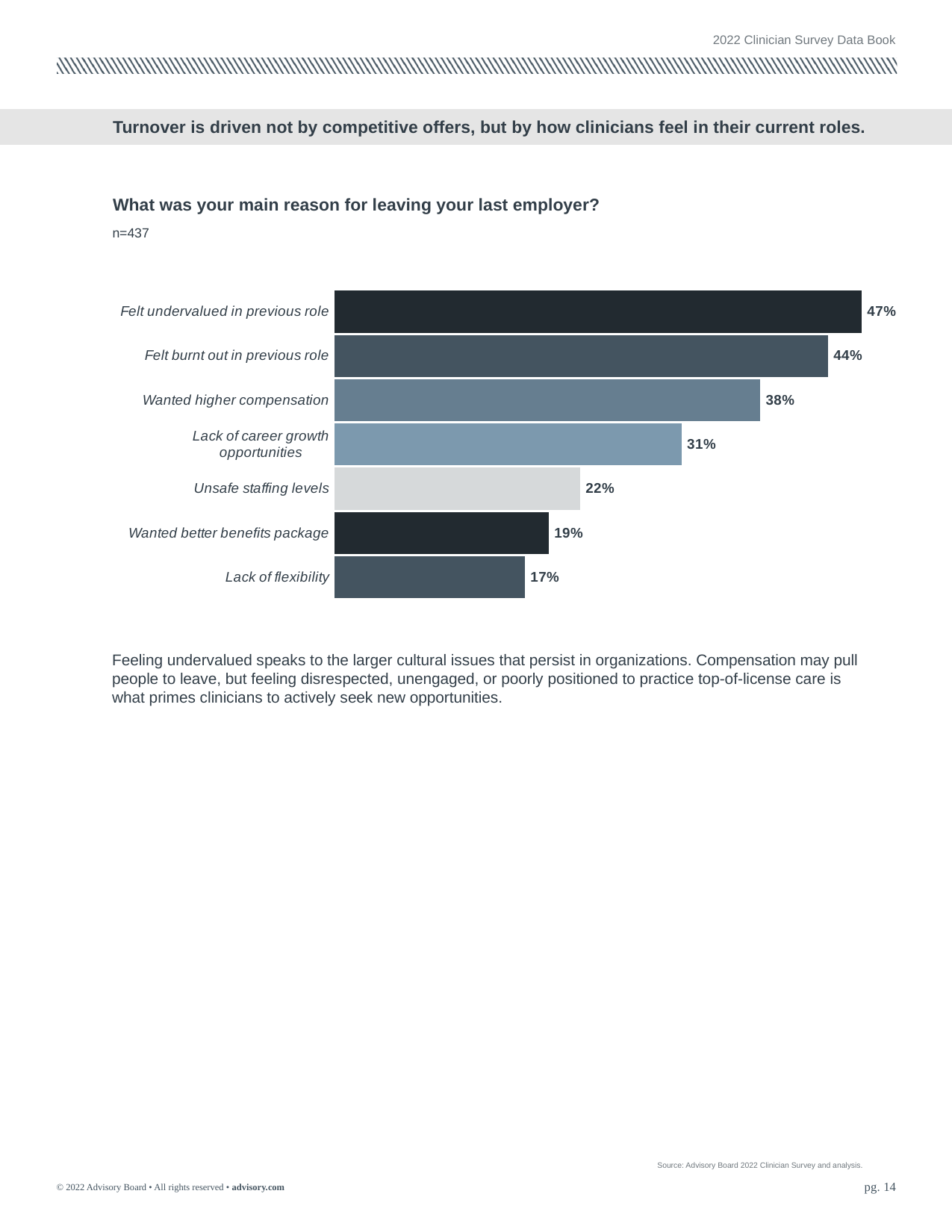
What is the value for 'Wanted higher compensation'? 38% What survey question does the chart present? What was your main reason for leaving your last employer? What percentage cited unsafe staffing levels as their main reason for leaving? 22% Which reason for leaving has the lowest percentage? Lack of flexibility What is the difference between 'Wanted higher compensation' and 'Wanted better benefits package'? 19% Which is larger: 'Lack of career growth opportunities' or 'Unsafe staffing levels'? Lack of career growth opportunities How many reasons for leaving are shown in the chart? 7 What is the difference between 'Felt undervalued in previous role' and 'Felt burnt out in previous role'? 3% What kind of chart is shown on the slide? Bar chart Which reason for leaving has the highest percentage? Felt undervalued in previous role What is the sample size (n) shown for the chart? n=437 What percentage of respondents said they felt undervalued in their previous role? 47%